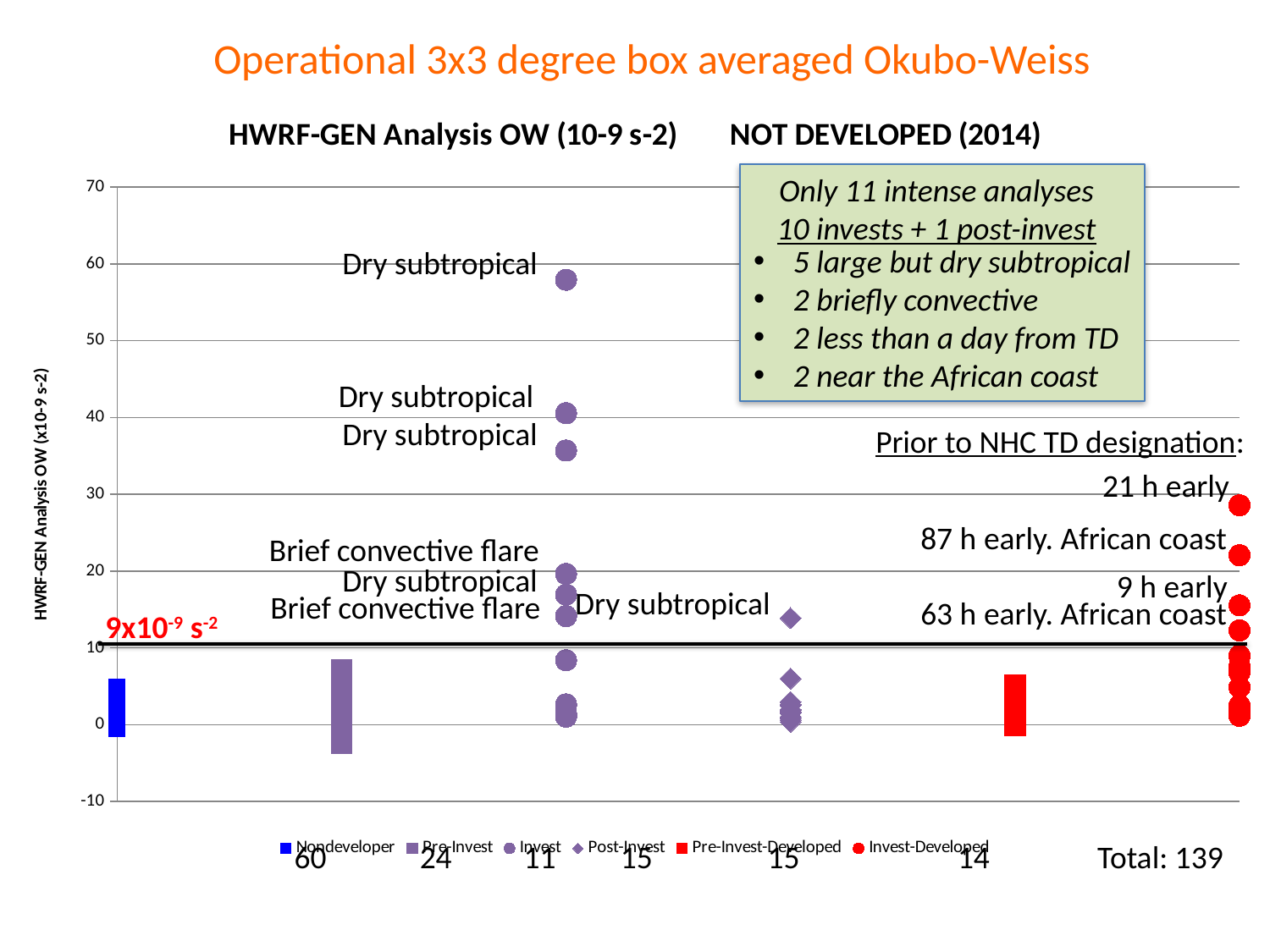
Is the highest Invest point greater or less than 50? greater Is the highest Post-Invest point greater or less than 20? less Which series has more plotted points above 30: Invest or Pre-Invest? Invest What is the title of the chart? HWRF-GEN Analysis OW (10-9 s-2) NOT DEVELOPED (2014) What is the label on the vertical axis? HWRF-GEN Analysis OW (x10-9 s-2) Is the highest Nondeveloper point greater or less than 10? less Which series contains the highest plotted point on the chart? Invest What is the highest tick value shown on the vertical axis? 70 What is the lowest tick value shown on the vertical axis? -10 What kind of chart is shown on the slide? scatter chart How many series does the legend list? 6